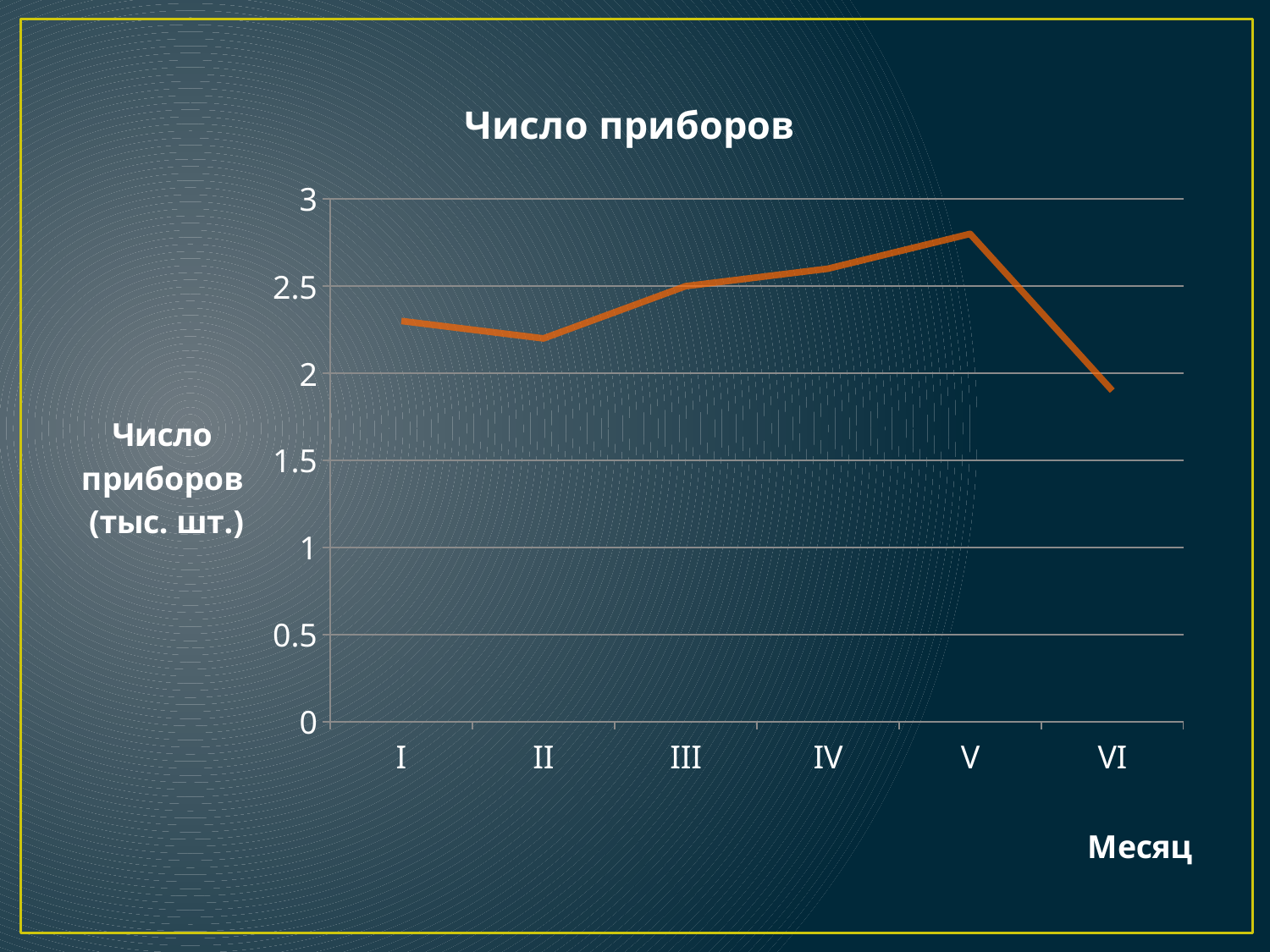
How many months (points) are plotted along the x axis? 6 Do the values rise or fall from month II to month V? rise Is the value for month I greater or less than 2.5? less Which month has the lowest number of devices? VI Is the value for month II greater or less than 2? greater Which month has the highest number of devices? V What kind of chart is shown on the slide? line chart Is the value for month VI greater or less than 2? less Which is larger, the value for month V or the value for month VI? V What is the label of the x axis? Месяц What is the title of the chart? Число приборов